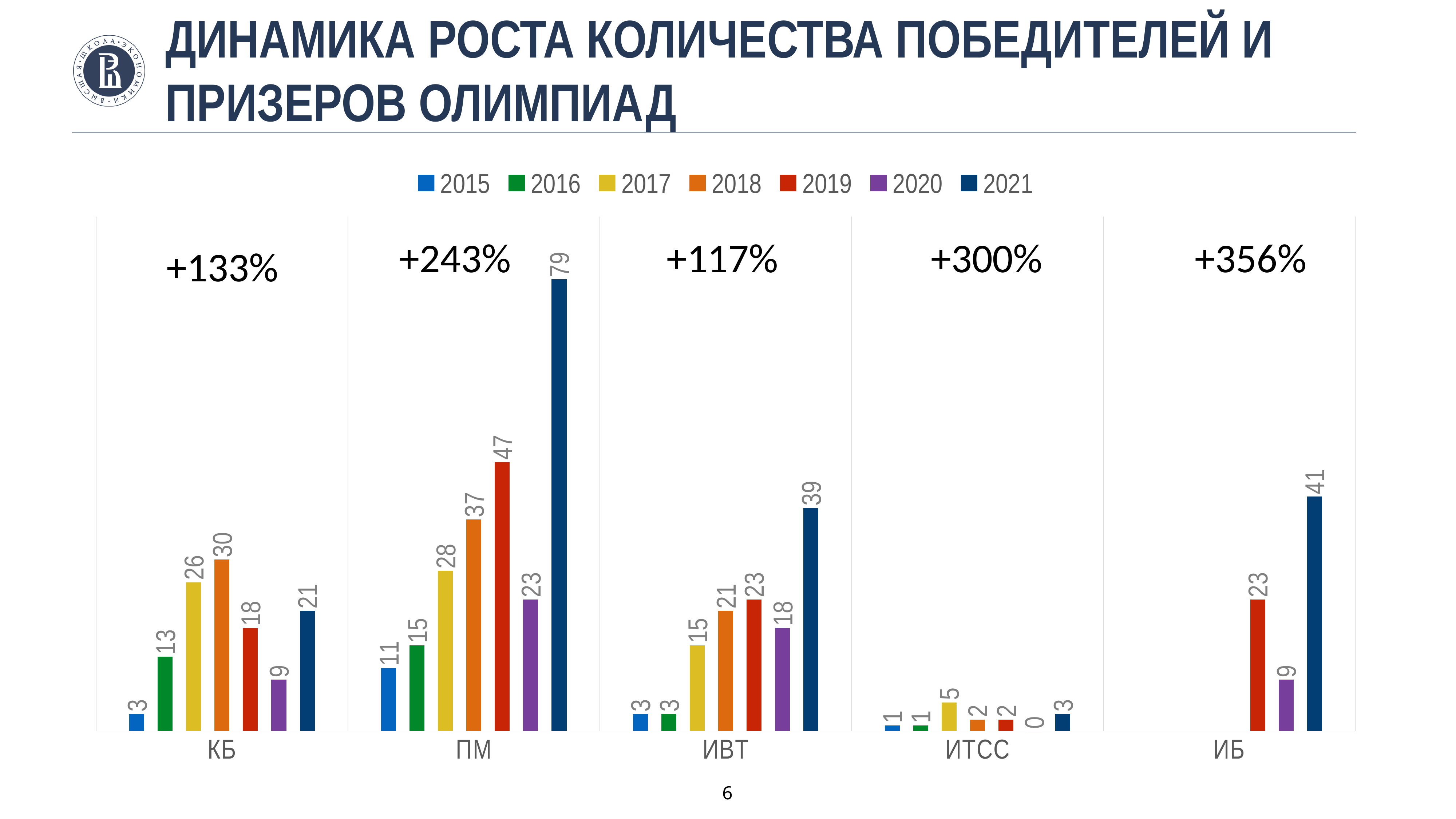
What is the value for ПМ in 2021? 79 How many series does the legend list? 7 What is the value for ИБ in 2019? 23 What is the difference between the 2021 and 2019 values for ПМ? 32 Which is larger for ИВТ: the 2018 value or the 2020 value? 2018 What is the value for ИТСС in 2020? 0 How many categories are shown on the x axis? 5 What percentage growth is annotated above the ИБ group? +356% What kind of chart is shown on the slide? Bar chart Which category has the highest value in 2021? ПМ Which category has the lowest value in 2019? ИТСС What is the value for КБ in 2018? 30